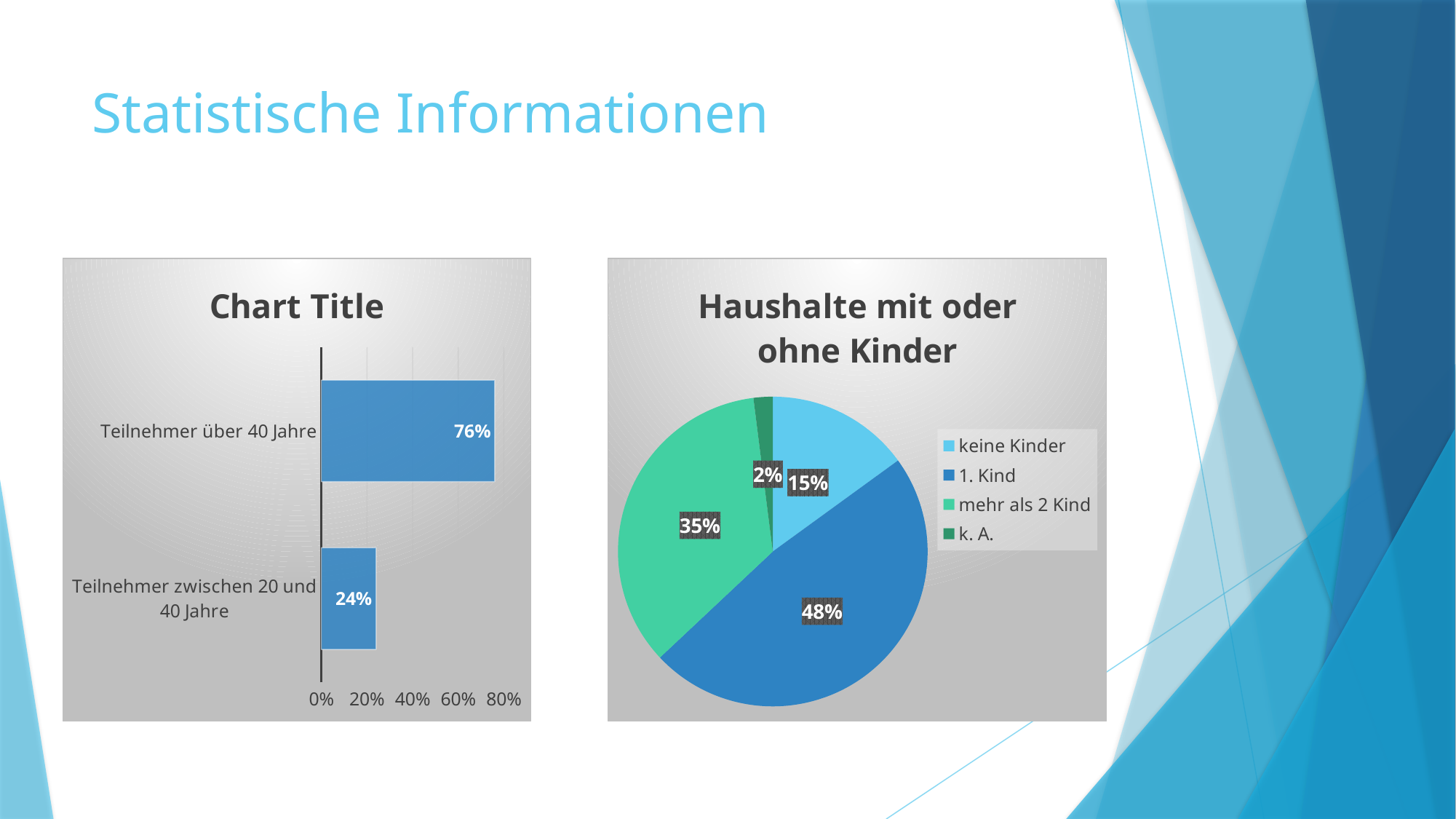
What kind of chart is the left chart titled "Chart Title"? Bar chart In the left chart titled "Chart Title", what is the difference between the values for "Teilnehmer über 40 Jahre" and "Teilnehmer zwischen 20 und 40 Jahre"? 52% In the pie chart "Haushalte mit oder ohne Kinder", what is the share for "mehr als 2 Kind"? 35% In the pie chart "Haushalte mit oder ohne Kinder", which category has the smallest slice? k. A. In the left chart titled "Chart Title", what is the value for "Teilnehmer über 40 Jahre"? 76% In the left chart titled "Chart Title", which category has the highest value? Teilnehmer über 40 Jahre In the left chart titled "Chart Title", how many categories are shown? 2 In the left chart titled "Chart Title", what is the value for "Teilnehmer zwischen 20 und 40 Jahre"? 24% What kind of chart is the right chart titled "Haushalte mit oder ohne Kinder"? Pie chart In the pie chart "Haushalte mit oder ohne Kinder", what is the share for "1. Kind"? 48% In the pie chart "Haushalte mit oder ohne Kinder", how many entries does the legend list? 4 In the pie chart "Haushalte mit oder ohne Kinder", which is larger: "keine Kinder" or "mehr als 2 Kind"? mehr als 2 Kind